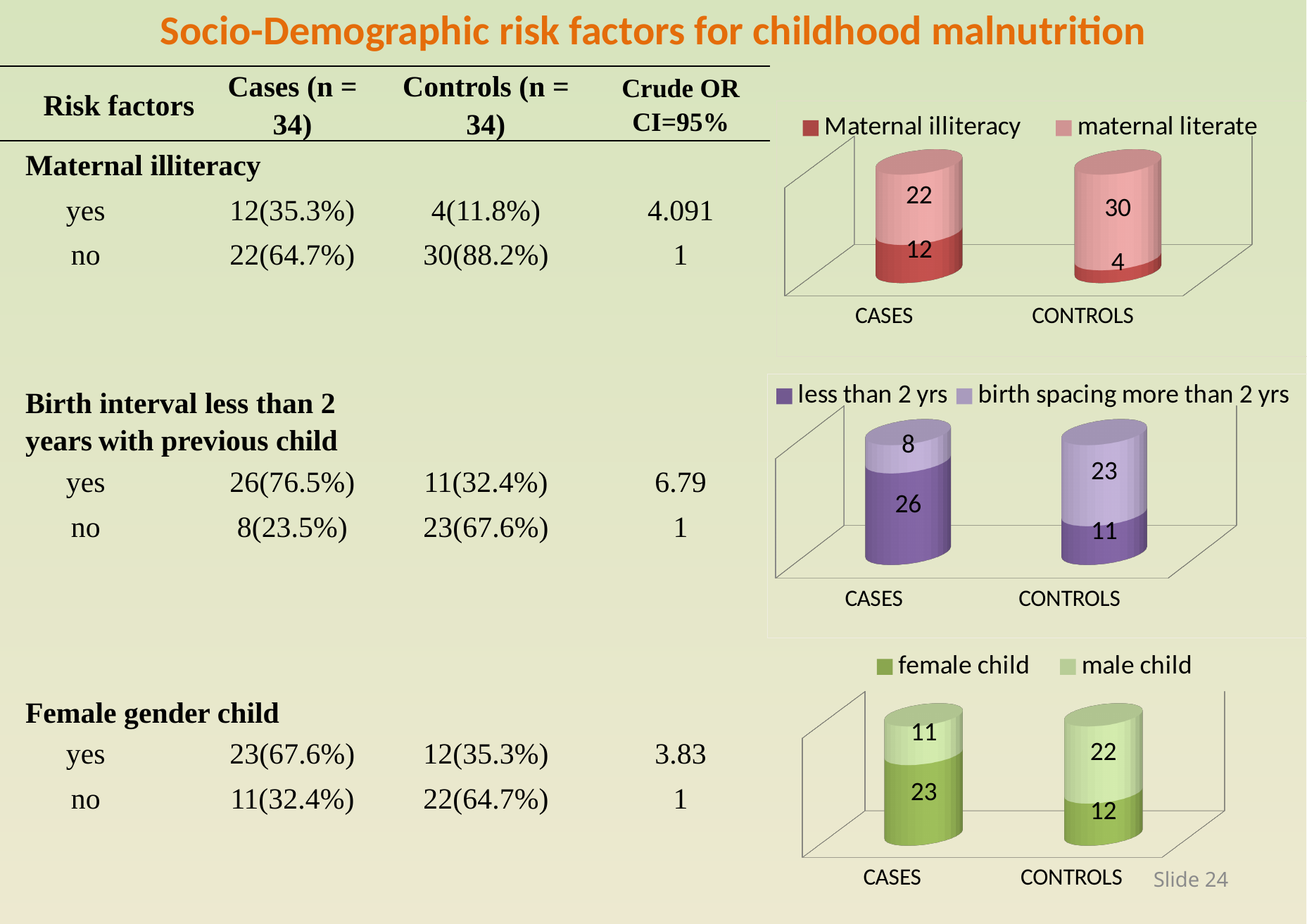
In the middle-right chart, how many series does the legend list? 2 In the top-right chart, what is the value for Maternal illiteracy in the CASES bar? 12 In the top-right chart, what is the difference between the maternal literate values for CONTROLS and CASES? 8 What kind of chart is the bottom-right chart? Stacked bar chart In the bottom-right chart, what is the value for female child in the CASES bar? 23 In the bottom-right chart, what is the difference between the female child values for CASES and CONTROLS? 11 In the middle-right chart, what is the value for less than 2 yrs in the CASES bar? 26 In the middle-right chart, what is the value for birth spacing more than 2 yrs in the CONTROLS bar? 23 In the bottom-right chart, what is the value for male child in the CONTROLS bar? 22 In the top-right chart, what is the total of the stacked CASES bar? 34 In the top-right chart, what is the value for maternal literate in the CONTROLS bar? 30 In the middle-right chart, which bar has the larger value for less than 2 yrs, CASES or CONTROLS? CASES